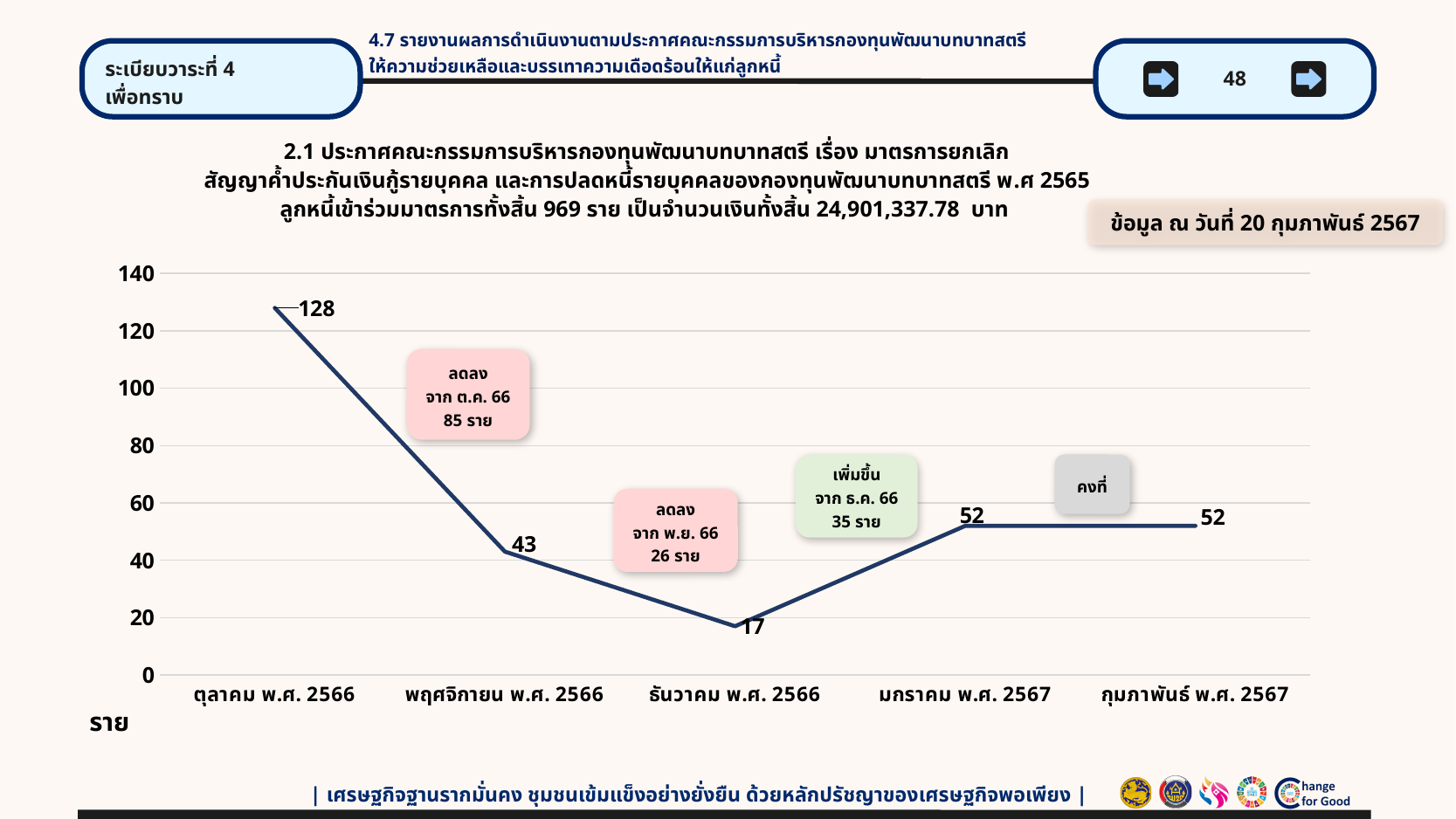
What type of chart is shown on the slide? line chart How many data points are plotted on the line chart? 5 What is the value for มกราคม พ.ศ. 2567? 52 What is the value for ตุลาคม พ.ศ. 2566? 128 What is the difference between the values for ตุลาคม พ.ศ. 2566 and พฤศจิกายน พ.ศ. 2566? 85 What is the value for ธันวาคม พ.ศ. 2566? 17 Which month has the lowest value? ธันวาคม พ.ศ. 2566 What is the value for พฤศจิกายน พ.ศ. 2566? 43 Which month has the highest value? ตุลาคม พ.ศ. 2566 Does the value rise or fall from ตุลาคม พ.ศ. 2566 to ธันวาคม พ.ศ. 2566? fall Which is larger, the value for พฤศจิกายน พ.ศ. 2566 or the value for กุมภาพันธ์ พ.ศ. 2567? กุมภาพันธ์ พ.ศ. 2567 What is the difference between the values for มกราคม พ.ศ. 2567 and ธันวาคม พ.ศ. 2566? 35